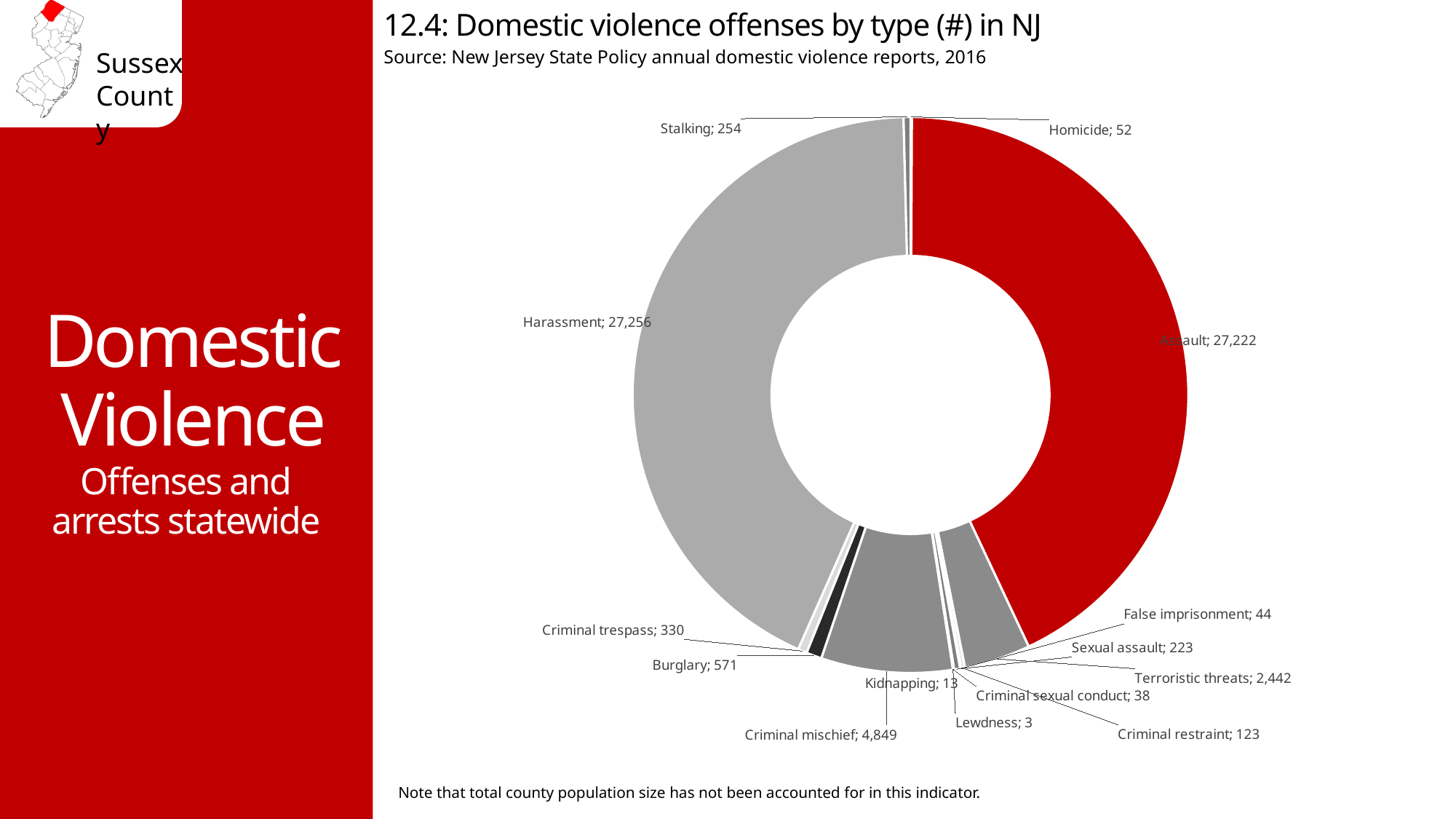
What is the number of Criminal mischief offenses shown on the chart? 4,849 What is the number of Homicide offenses shown on the chart? 52 What is the difference between the Criminal mischief and Terroristic threats counts? 2,407 Which is larger, the Burglary count or the Criminal trespass count? Burglary How many offense types are shown on the chart? 14 What is the number of Assault offenses shown on the chart? 27,222 What is the number of Terroristic threats offenses shown on the chart? 2,442 What is the number of Harassment offenses shown on the chart? 27,256 Which offense type has the lowest number on the chart? Lewdness Which offense type has the highest number on the chart? Harassment What kind of chart is used on this slide? Doughnut chart What is the difference between the Harassment and Assault counts? 34